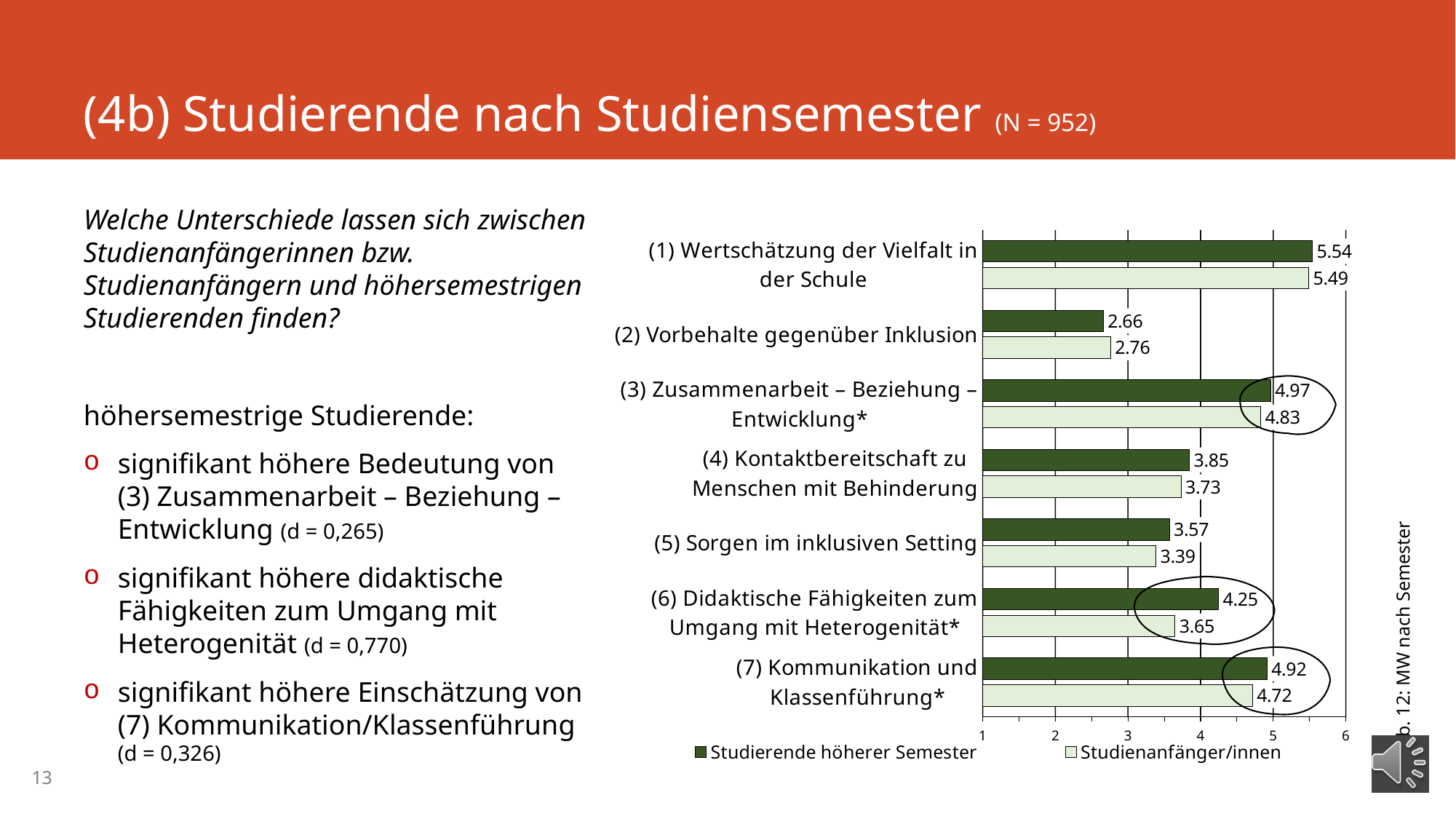
How many categories are shown on the chart? 7 What is the difference between Studierende höherer Semester and Studienanfänger/innen for (6) Didaktische Fähigkeiten zum Umgang mit Heterogenität*? 0.60 Which category has the lowest value for Studienanfänger/innen? (2) Vorbehalte gegenüber Inklusion Which category has the highest value for Studierende höherer Semester? (1) Wertschätzung der Vielfalt in der Schule Is the value for Studienanfänger/innen for (4) Kontaktbereitschaft zu Menschen mit Behinderung greater or less than 4? less Which series is shown with dark green bars? Studierende höherer Semester What is the value for Studienanfänger/innen for (2) Vorbehalte gegenüber Inklusion? 2.76 What is the value for Studierende höherer Semester for (6) Didaktische Fähigkeiten zum Umgang mit Heterogenität*? 4.25 How many series does the chart legend list? 2 For (5) Sorgen im inklusiven Setting, which series has the larger value: Studierende höherer Semester or Studienanfänger/innen? Studierende höherer Semester What is the value for Studienanfänger/innen for (7) Kommunikation und Klassenführung*? 4.72 What kind of chart is shown on the slide? bar chart